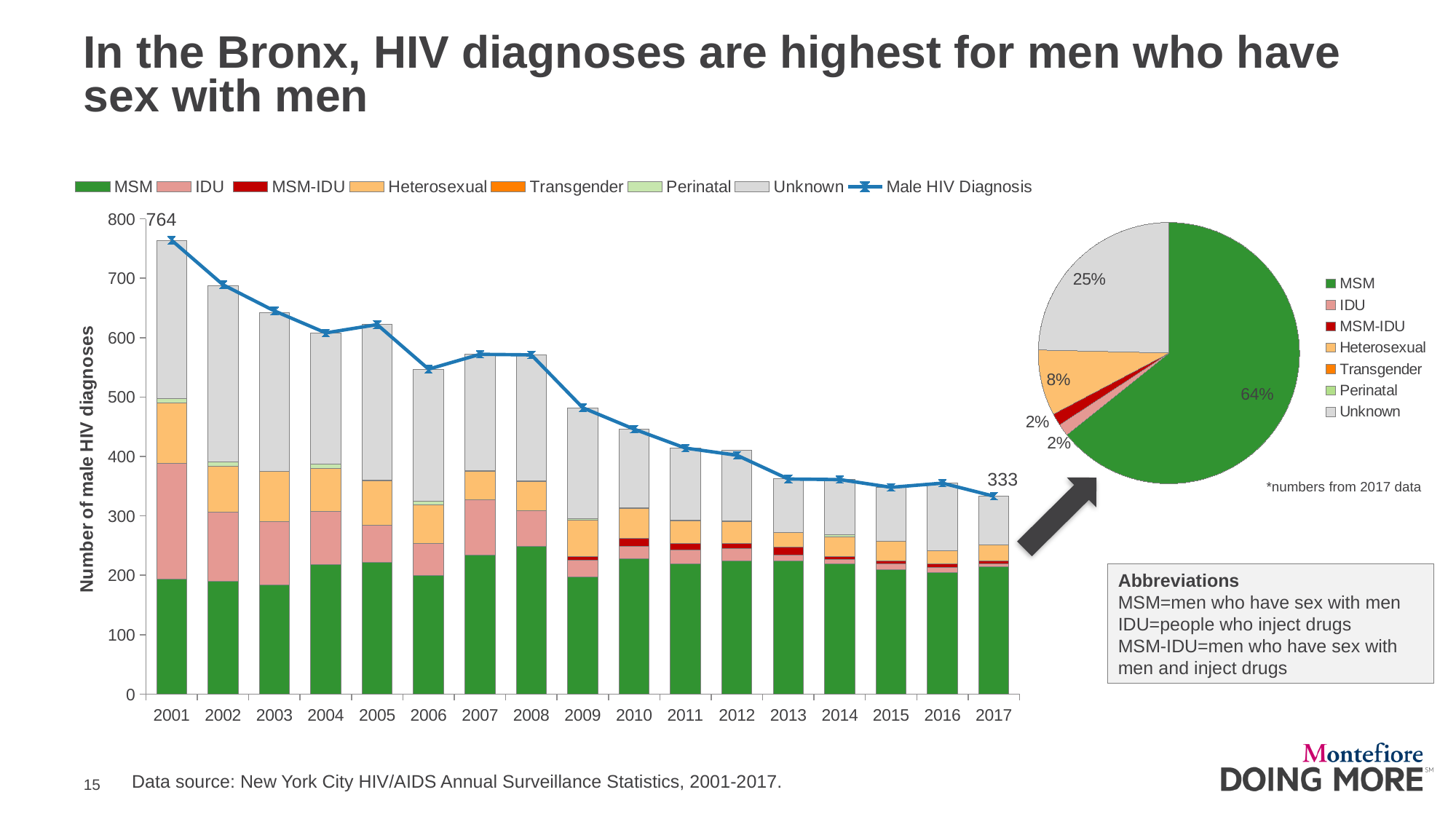
In the bar chart, what is the Male HIV Diagnosis value for 2017? 333 In the bar chart, does the Male HIV Diagnosis line rise or fall from 2001 to 2017? Fall How many entries does the legend of the bar chart list? 8 What kind of chart is on the left of the slide? Stacked bar chart with a line In the pie chart, what share is Unknown? 25% In the bar chart, what is the Male HIV Diagnosis value for 2001? 764 In the pie chart, which category has the largest slice? MSM In the bar chart, by how much did the Male HIV Diagnosis value fall from 2001 to 2017? 431 How many years are shown on the x axis of the bar chart? 17 In the bar chart, is the Male HIV Diagnosis value for 2010 greater or less than 500? less In the pie chart, what share of 2017 male HIV diagnoses is MSM? 64% In the pie chart, what share is Heterosexual? 8%